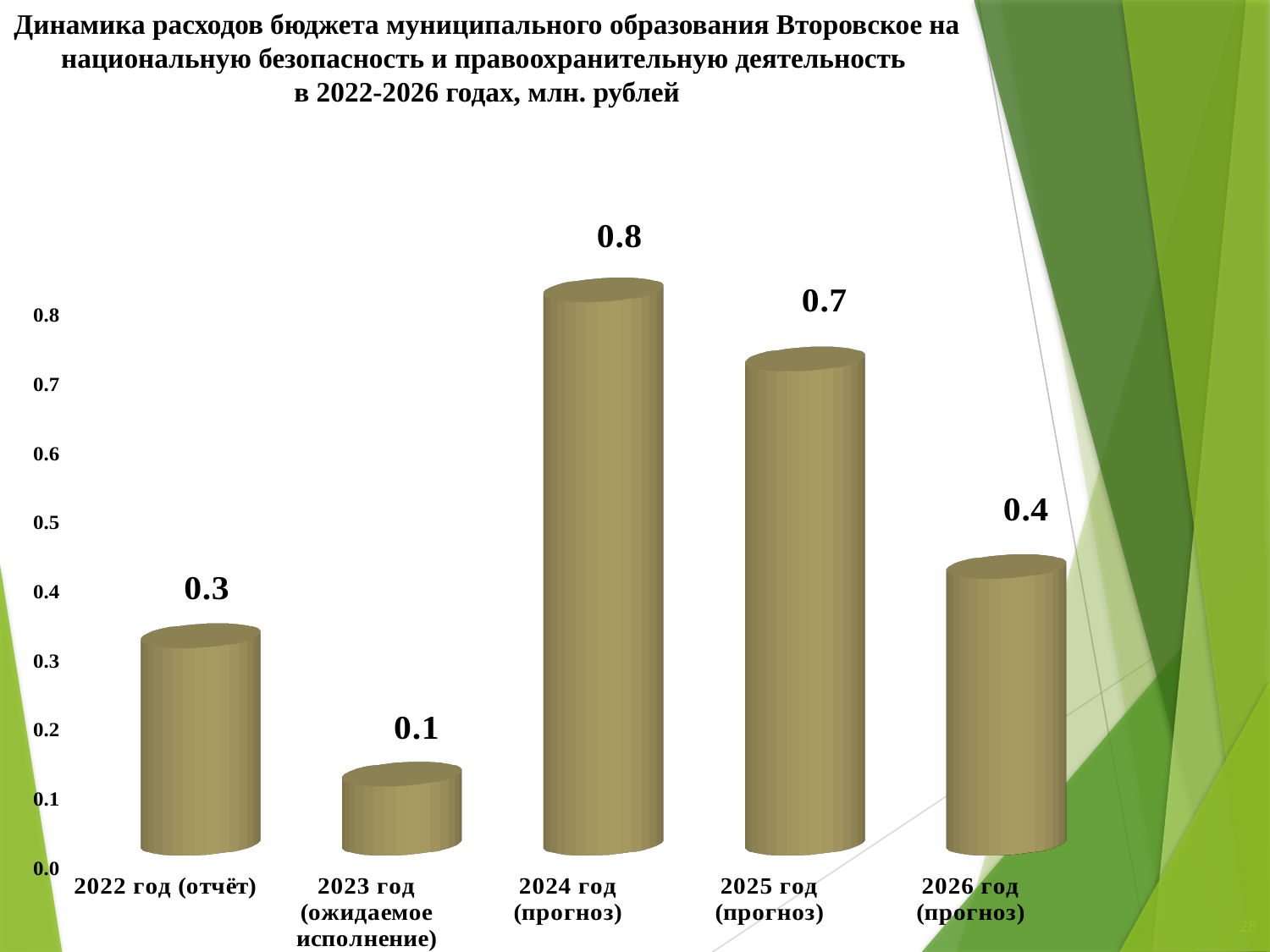
What is the difference between the values for 2024 год (прогноз) and 2025 год (прогноз)? 0.1 What is the value for 2024 год (прогноз)? 0.8 Which is larger, the value for 2022 год (отчёт) or the value for 2026 год (прогноз)? 2026 год (прогноз) Which year has the highest value? 2024 год (прогноз) What is the value for 2023 год (ожидаемое исполнение)? 0.1 Which year has the lowest value? 2023 год (ожидаемое исполнение) What unit of measurement is stated in the chart title? млн. рублей How many years are shown on the chart? 5 What is the value for 2026 год (прогноз)? 0.4 What is the value for 2022 год (отчёт)? 0.3 What kind of chart is shown on the slide? bar chart Is the value for 2025 год (прогноз) greater or less than 0.5? greater